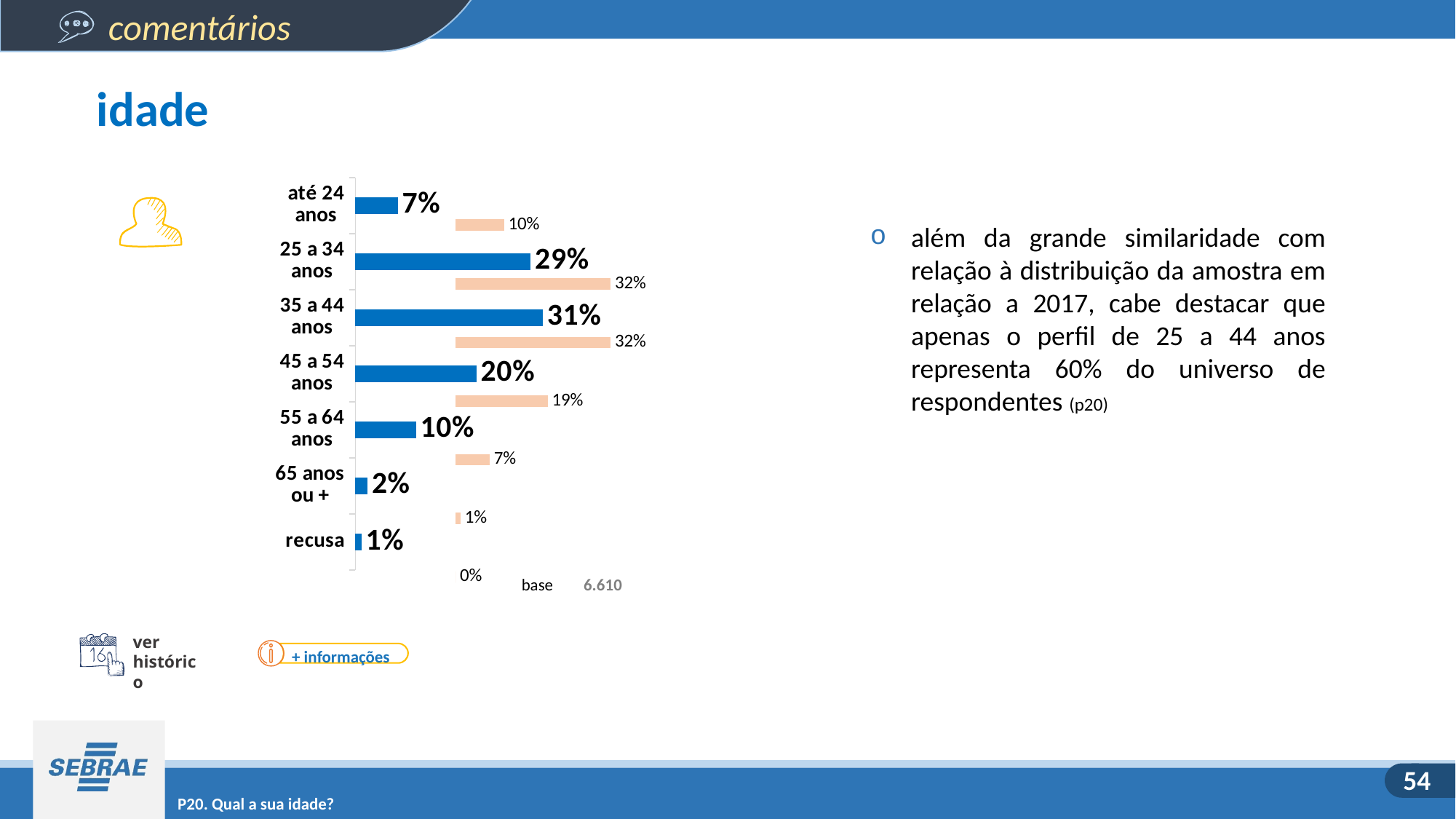
How many age categories are shown on the chart? 6 What is the value of the light orange bar for '45 a 54 anos'? 19% What is the base (number of respondents) shown below the chart? 6.610 Which category has the lowest value among the blue bars? recusa Which category has the highest value among the blue bars? 35 a 44 anos What is the value of the blue bar for '25 a 34 anos'? 29% What is the difference between the blue bar values for '35 a 44 anos' and '45 a 54 anos'? 11% What is the value of the blue bar for '35 a 44 anos'? 31% What is the difference between the light orange and blue bar values for '55 a 64 anos'? 3% Which is larger for '45 a 54 anos': the blue bar or the light orange bar? the blue bar What type of chart is shown on the slide? bar chart What is the value of the light orange bar for 'até 24 anos'? 10%